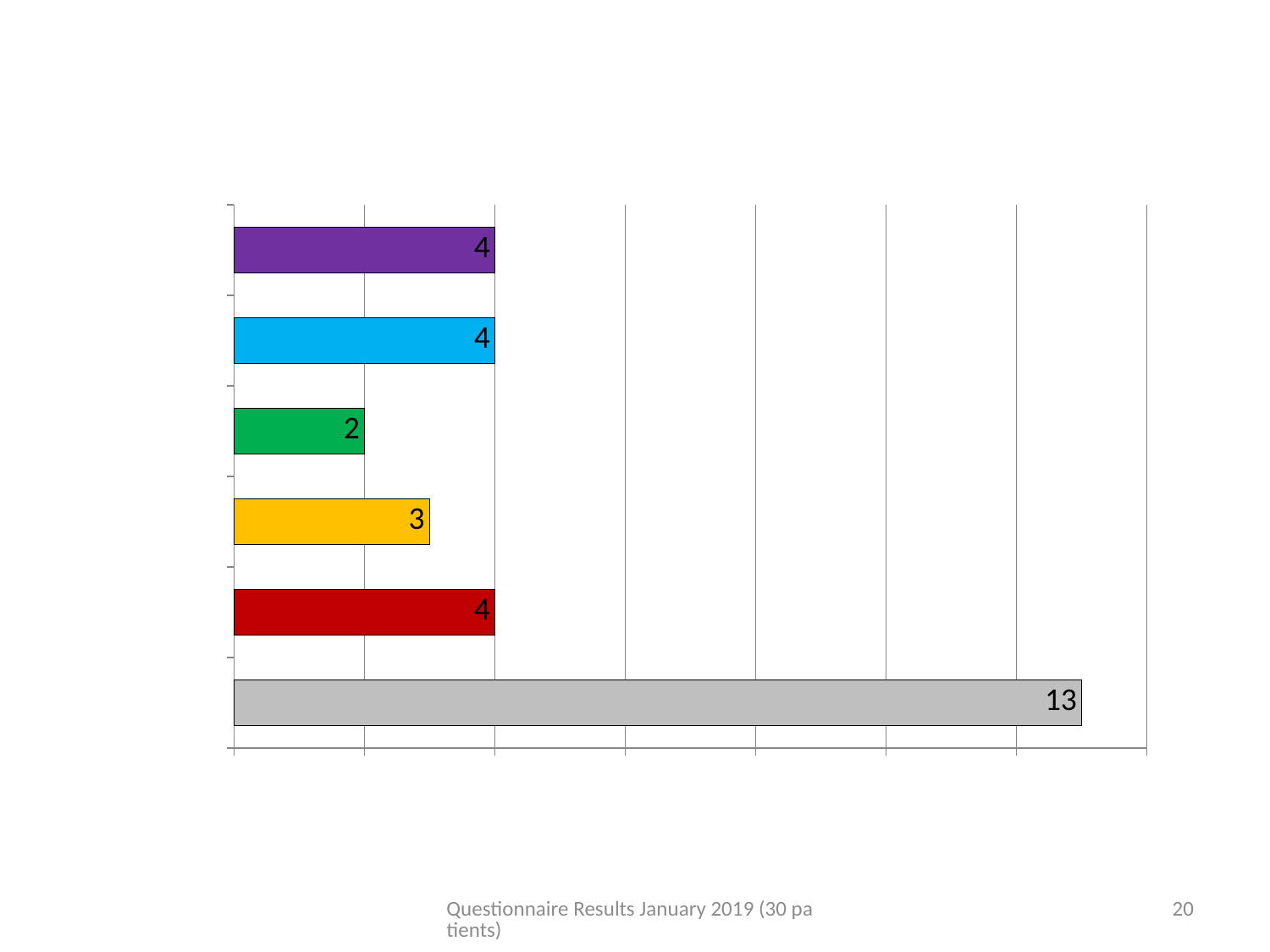
What is the value of the yellow bar? 3 Which bar has the lowest value? The green bar (2) Which is larger, the yellow bar or the green bar? The yellow bar What is the value of the red bar? 4 What is the value of the green bar? 2 What is the value of the purple bar at the top of the chart? 4 What kind of chart is shown on the slide? Bar chart What is the value of the grey bar at the bottom of the chart? 13 What colour is the longest bar in the chart? Grey Which bar has the highest value? The grey bar (13) How many bars are plotted in the chart? 6 What is the difference between the grey bar and the red bar? 9